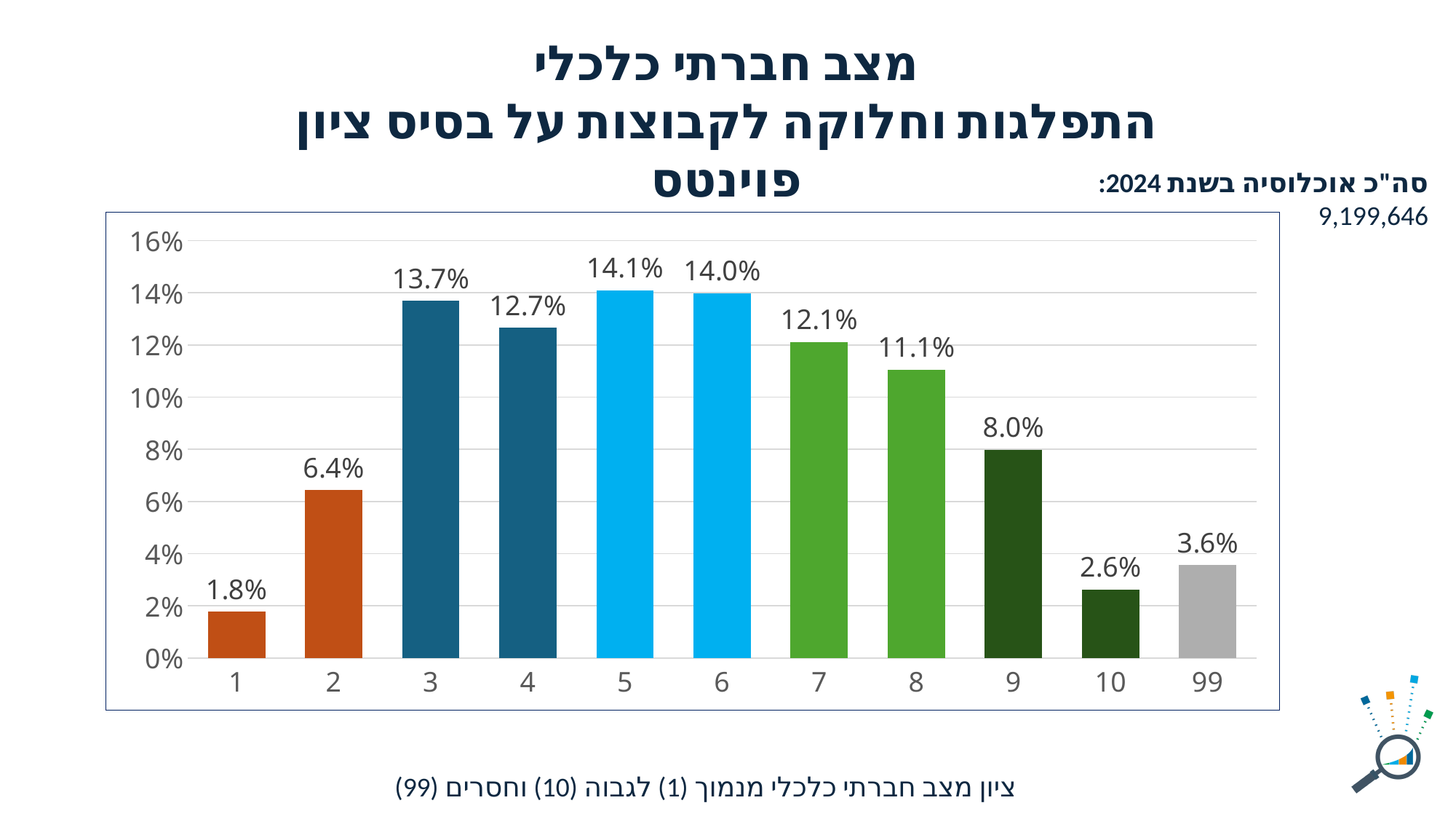
What is the value for category 99? 3.6% What is the difference between the values for category 9 and category 10? 5.4% Do the values rise or fall from category 6 to category 10? fall What kind of chart is shown on the slide? bar chart What is the value for category 3? 13.7% Which is larger, the value for category 2 or the value for category 8? 8 What is the value for category 7? 12.1% Is the value for category 4 greater or less than 12%? greater What colour is the bar for category 99? grey Which category has the lowest value? 1 How many categories are shown on the x axis? 11 Which category has the highest value? 5